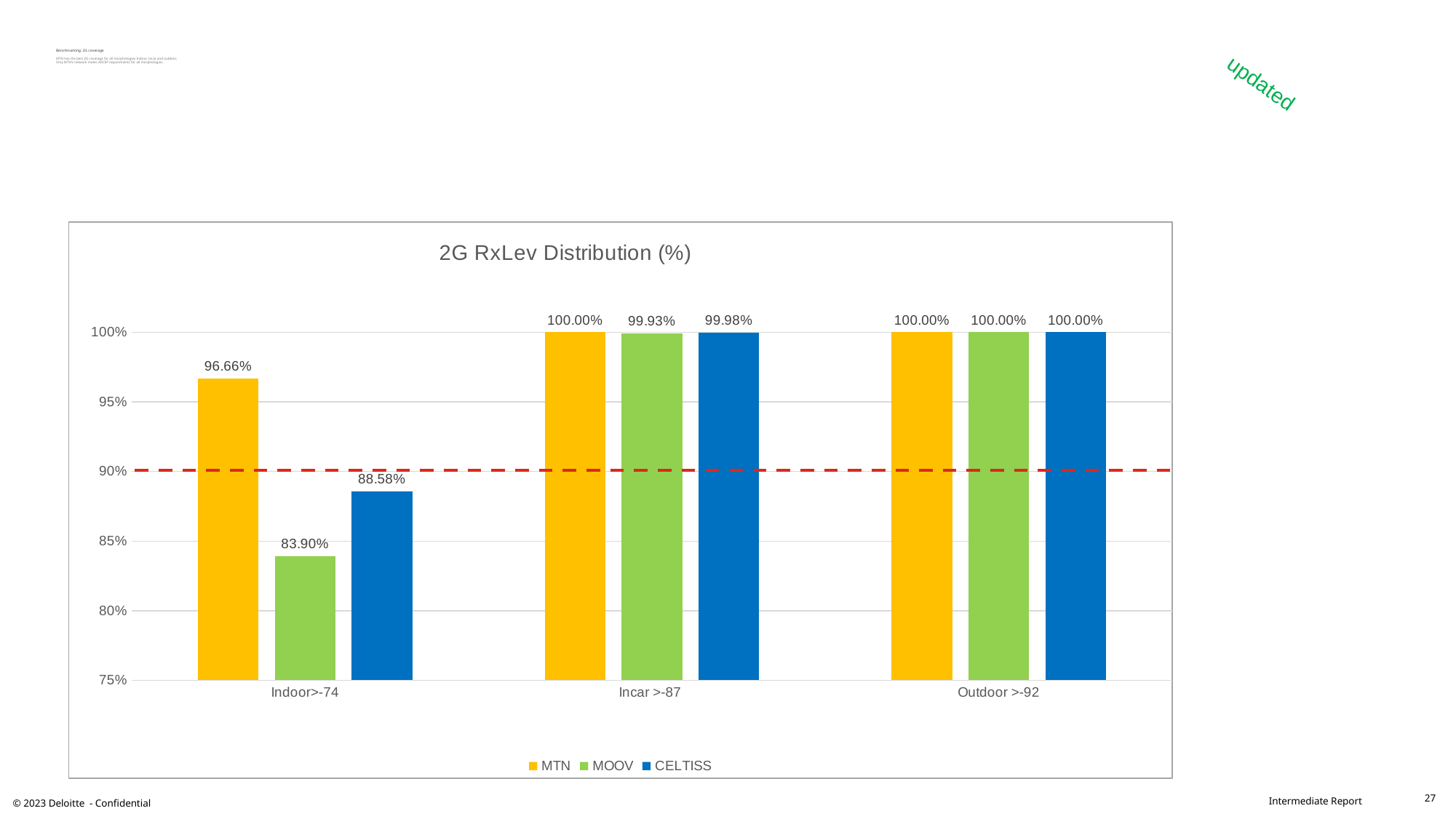
Which operator has the lowest value in the Indoor>-74 category? MOOV What is the value for MOOV in the Indoor>-74 category? 83.90% Which is larger in the Indoor>-74 category: the CELTISS value or the MOOV value? CELTISS What is the value for CELTISS in the Incar >-87 category? 99.98% What kind of chart is shown on the slide? bar chart Is the value for MOOV in the Indoor>-74 category greater or less than 85%? less What is the value for MTN in the Indoor>-74 category? 96.66% How many series does the legend list? 3 What is the title of the chart? 2G RxLev Distribution (%) What is the difference between the MTN and CELTISS values in the Indoor>-74 category? 8.08% How many categories are shown on the x axis? 3 Which operator has the highest value in the Indoor>-74 category? MTN